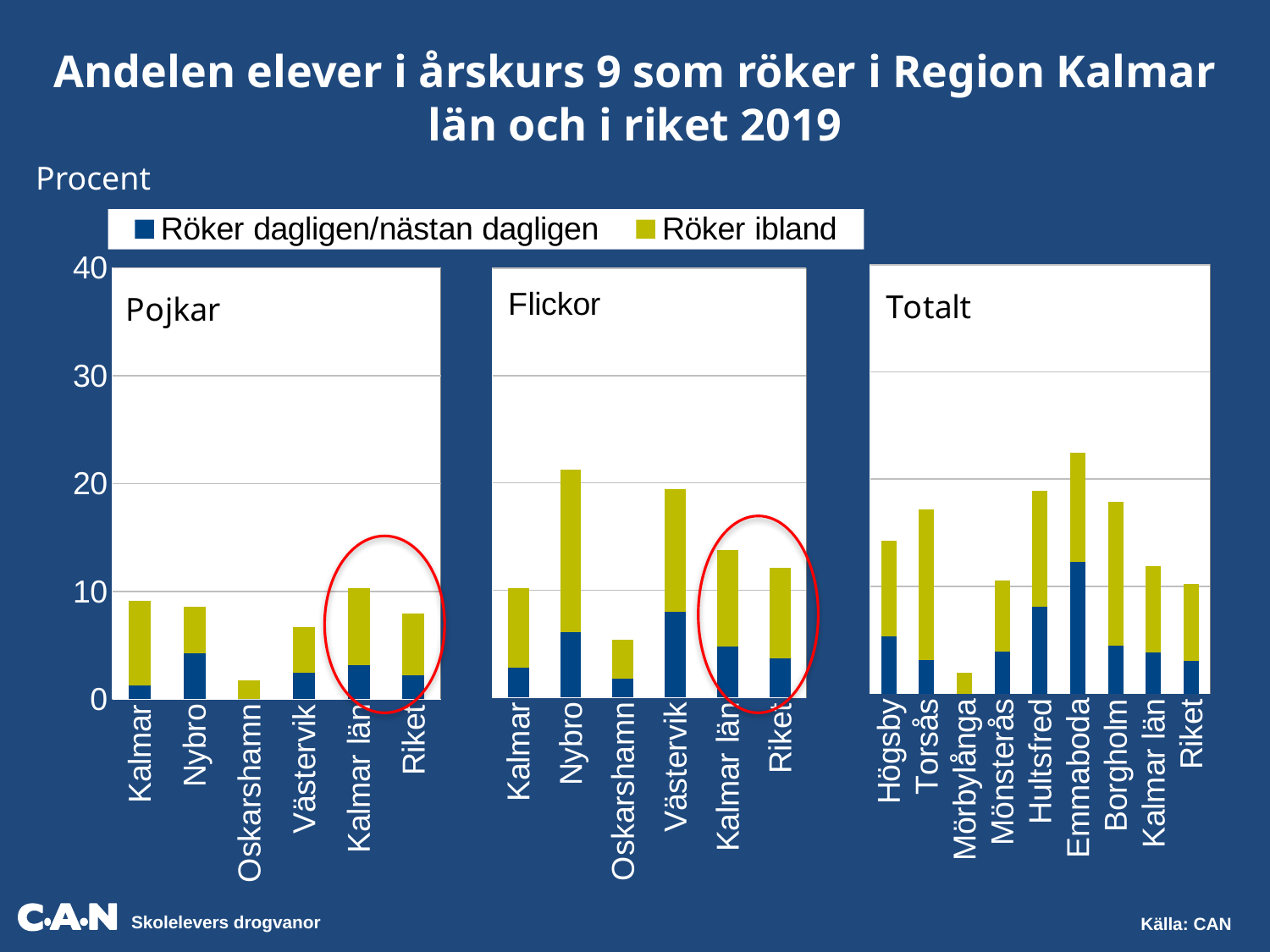
How many series does the legend list? 2 In the Totalt chart, how many categories are shown on the x axis? 9 Which series is shown in dark blue in the legend? Röker dagligen/nästan dagligen In the Flickor chart, is the total value for Nybro greater or less than 20? greater In the Totalt chart, which category has the lowest total bar? Mörbylånga In the Flickor chart, which category has the highest total bar? Nybro In the Flickor chart, which has the larger total bar, Västervik or Oskarshamn? Västervik In the Pojkar chart, which category has the lowest total bar? Oskarshamn In the Totalt chart, is the total value for Mörbylånga greater or less than 10? less In the Totalt chart, which category has the highest total bar? Emmaboda What kind of chart is used on this slide for the Pojkar, Flickor and Totalt panels? Stacked bar chart In the Pojkar chart, how many categories are shown on the x axis? 6